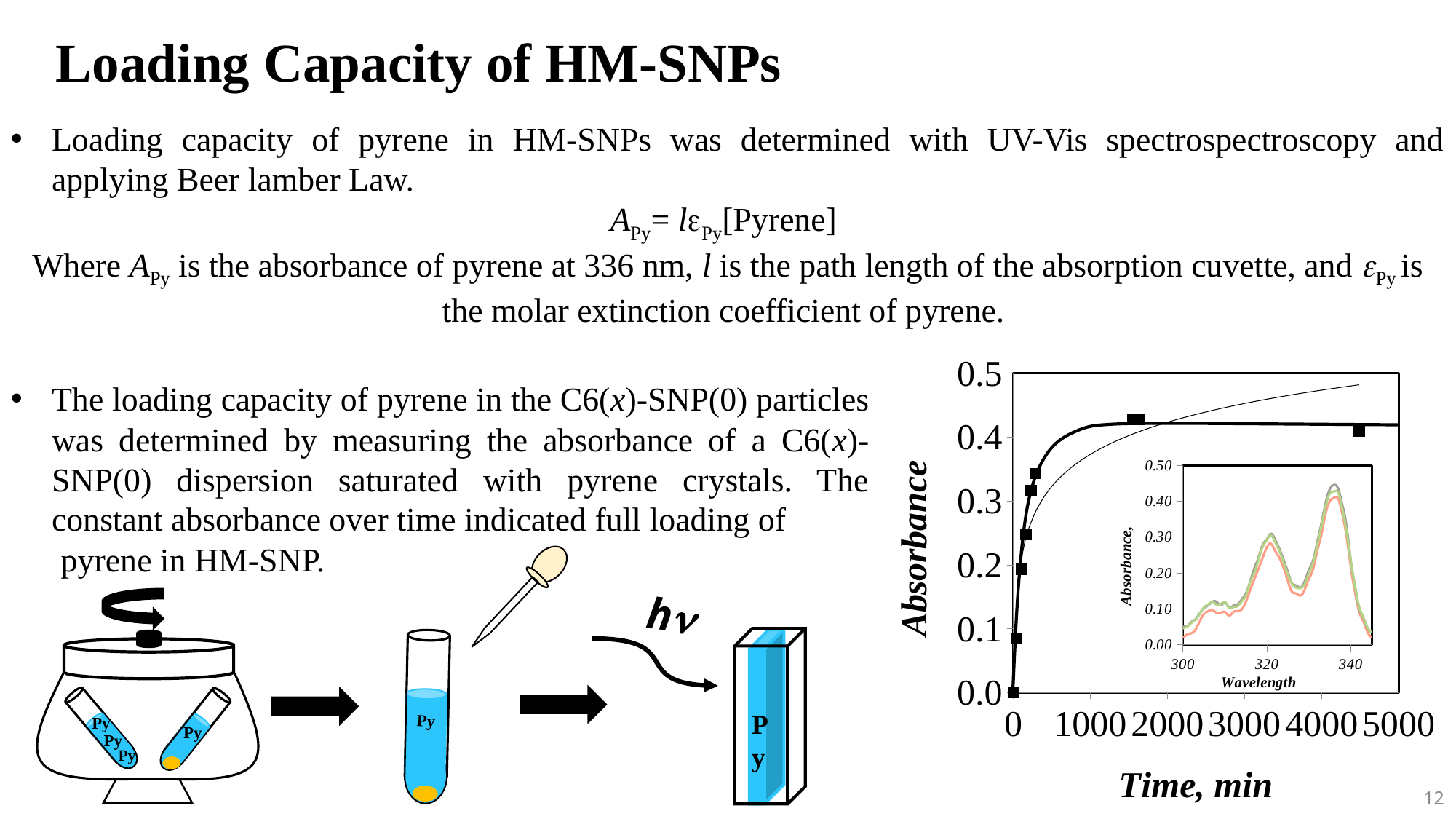
What kind of chart is the main chart on the right of the slide (Absorbance vs Time, min)? scatter chart with fitted lines In the main chart, what is the label of the y axis? Absorbance In the main chart, is the absorbance of the data point near 100 min greater or less than 0.3? less In the main chart, what is the label of the x axis? Time, min In the inset chart, which wavelength region has the higher absorbance peak: near 320 nm or near 336 nm? near 336 nm In the inset chart (Absorbance vs Wavelength), is the absorbance at the tallest peak near 336 nm greater or less than 0.40? greater In the main chart, is the absorbance of the data point near 1500 min greater or less than 0.4? greater In the main chart, what is the highest value shown on the x axis? 5000 In the main chart, what is the absorbance of the data point at time 0? 0.0 In the main chart, does the absorbance rise or fall as time increases from 0? rises